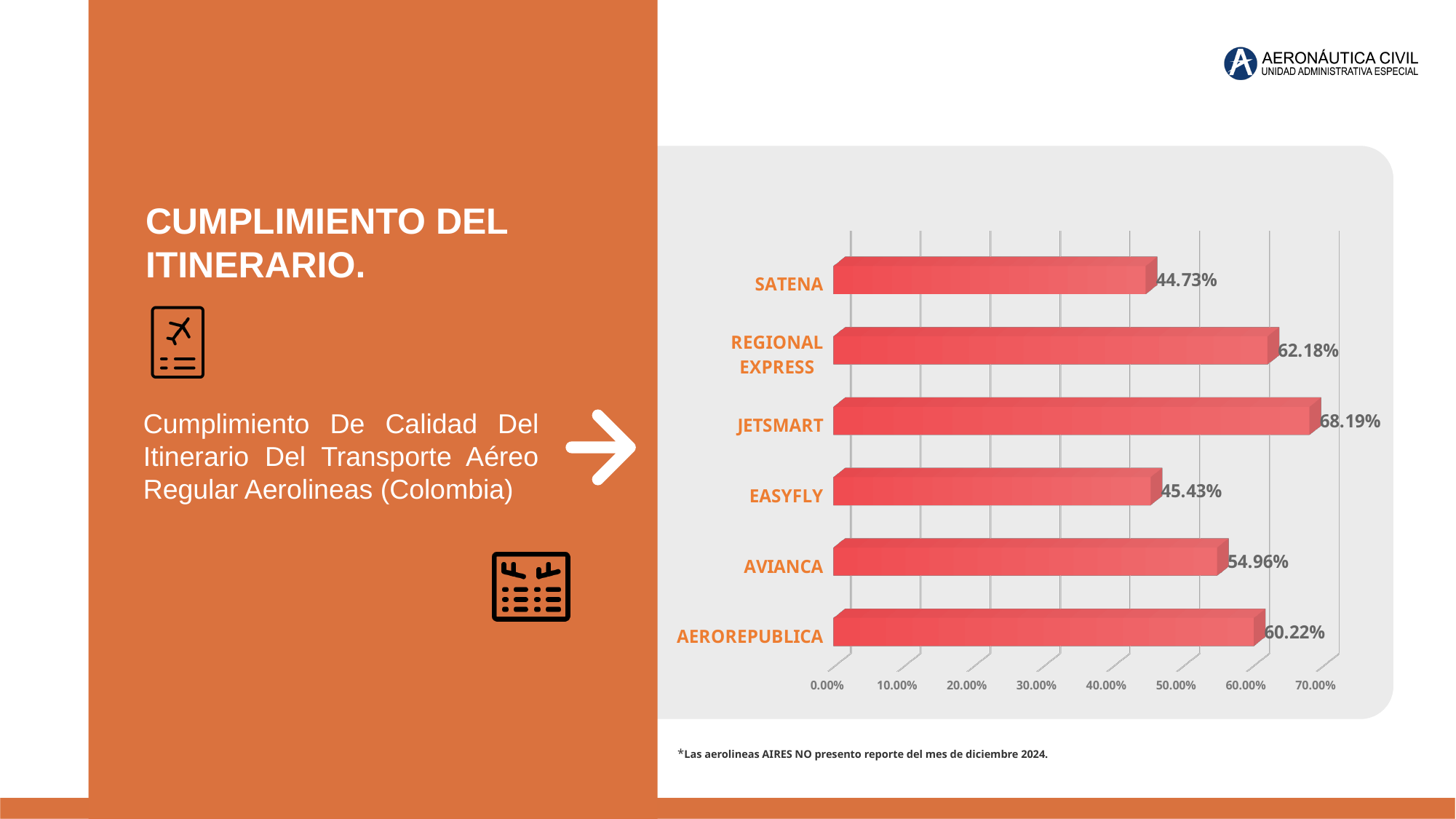
Which is larger, the value for AVIANCA or the value for AEROREPUBLICA? AEROREPUBLICA What is the value for JETSMART? 68.19% How many airlines are shown in the chart? 6 Which airline has the lowest value? SATENA What is the value for AEROREPUBLICA? 60.22% What is the difference between the values for AVIANCA and EASYFLY? 9.53% What kind of chart is shown on the slide? Bar chart What is the difference between the values for JETSMART and SATENA? 23.46% What is the highest value shown on the x axis of the chart? 70.00% What is the value for REGIONAL EXPRESS? 62.18% What is the value for AVIANCA? 54.96% Which airline has the highest value? JETSMART